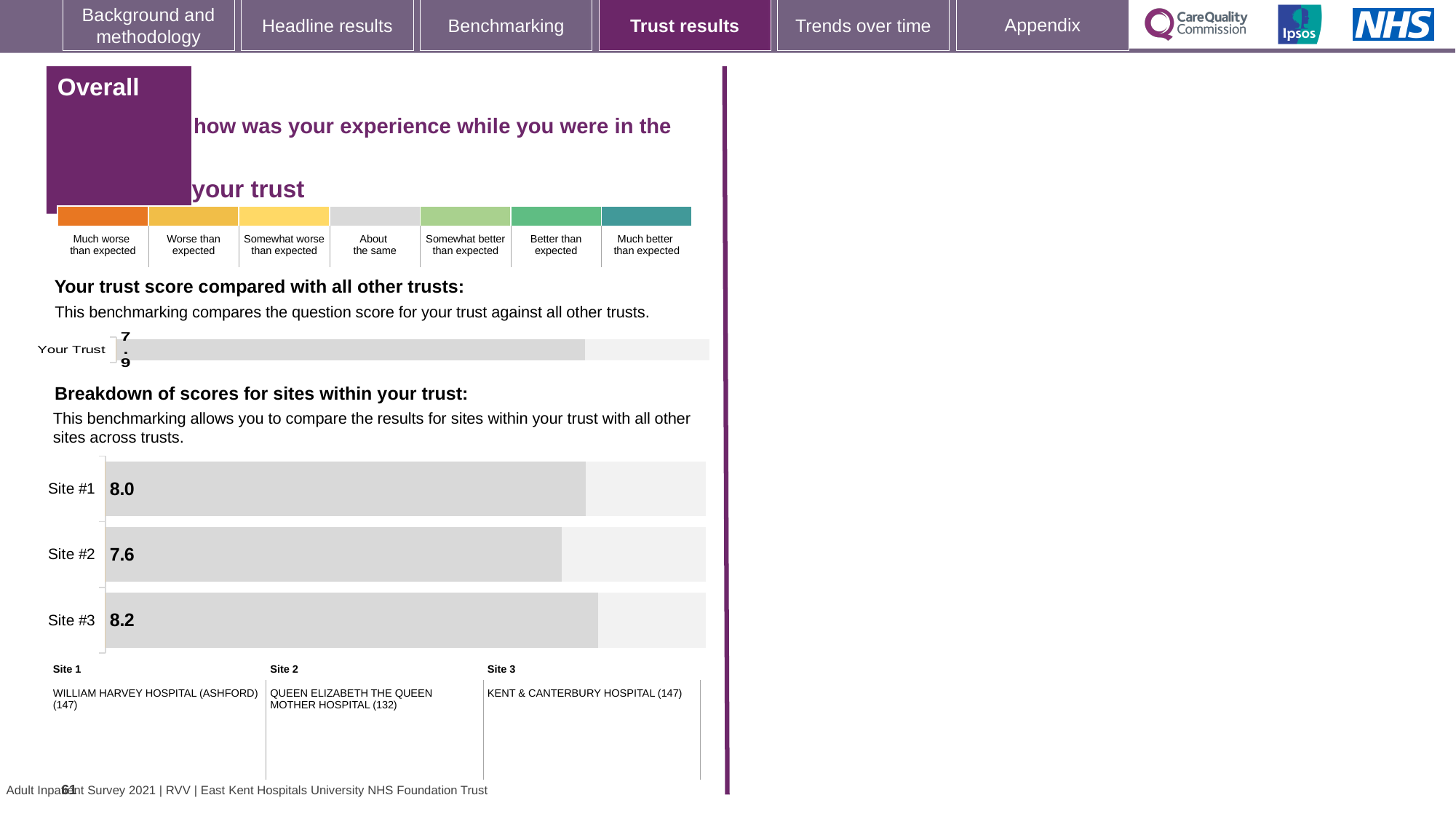
In the 'Breakdown of scores for sites within your trust' chart, what is the score for Site #1? 8.0 How many categories are shown in the 'Your trust score compared with all other trusts' chart? 1 In the 'Breakdown of scores for sites within your trust' chart, what is the difference between the scores for Site #3 and Site #2? 0.6 In the 'Breakdown of scores for sites within your trust' chart, which has the larger score, Site #1 or Site #2? Site #1 What kind of chart is the 'Breakdown of scores for sites within your trust' chart? Bar chart How many sites are shown in the 'Breakdown of scores for sites within your trust' chart? 3 In the 'Breakdown of scores for sites within your trust' chart, what is the score for Site #3? 8.2 In the 'Breakdown of scores for sites within your trust' chart, which site has the lowest score? Site #2 In the 'Breakdown of scores for sites within your trust' chart, what is the score for Site #2? 7.6 In the 'Your trust score compared with all other trusts' chart, what is the score for Your Trust? 7.9 In the 'Breakdown of scores for sites within your trust' chart, what is the difference between the scores for Site #1 and Site #2? 0.4 In the 'Breakdown of scores for sites within your trust' chart, which site has the highest score? Site #3